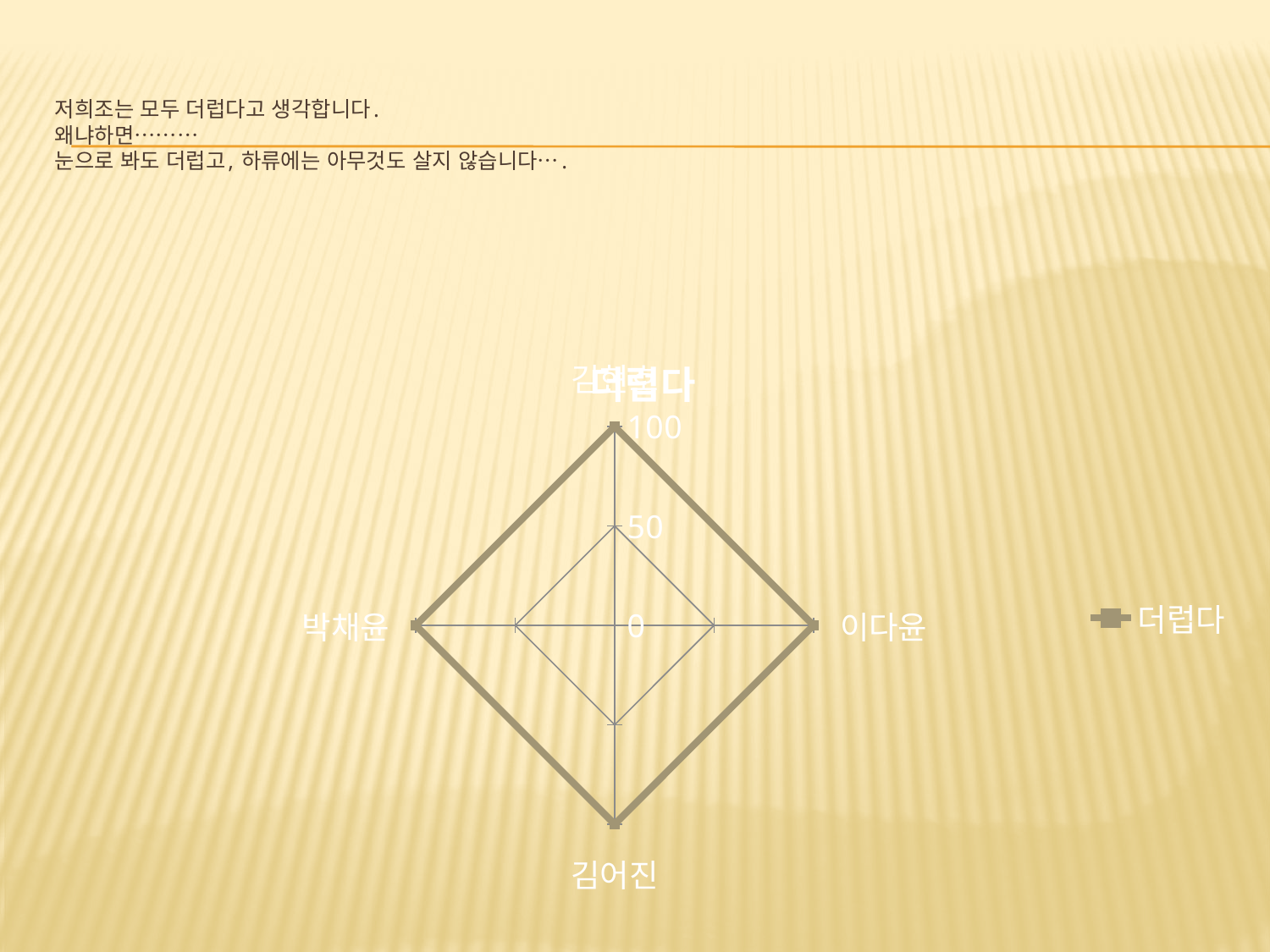
How many series does the legend list? 1 What is the name of the series shown in the legend? 더럽다 Is the value for 김어진 greater or less than 50? greater What is the value for 이다윤? 100 What kind of chart is shown on the slide? radar chart What is the highest tick value shown on the chart's axis? 100 How many categories (axes) does the radar chart have? 4 What is the value for 김어진? 100 What is the value for 박채윤? 100 Is the value for 박채윤 greater or less than 50? greater